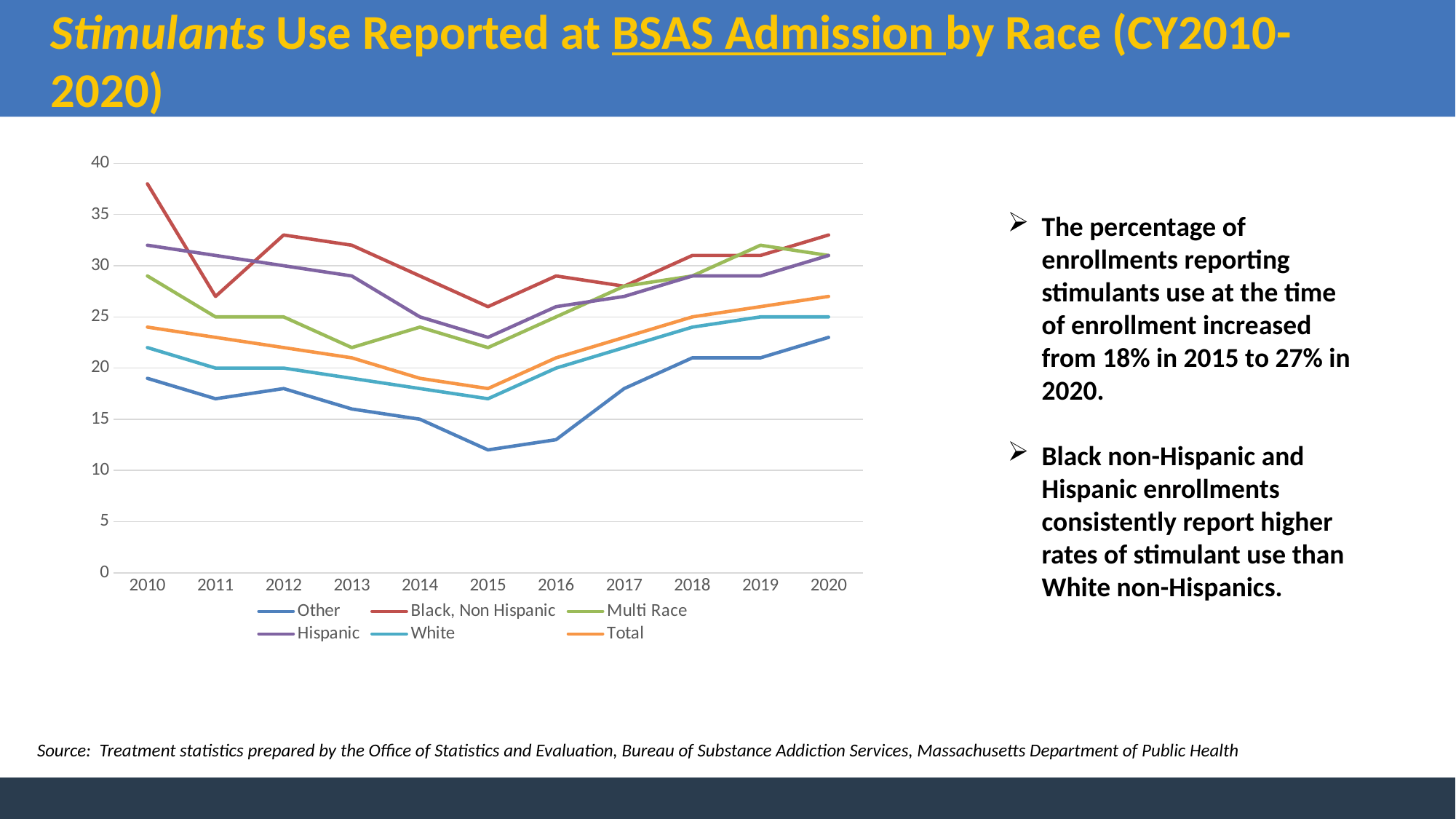
How many series does the legend list? 6 Is the value for Other in 2015 greater or less than 15? less In 2013, which is larger: the value for Hispanic or the value for White? Hispanic What kind of chart is shown on the slide? Line chart Is the value for Black, Non Hispanic in 2010 greater or less than 35? greater Which series has the lowest value in 2015? Other According to the slide, what percentage of enrollments reported stimulants use in 2020? 27% Which series has the highest value in 2010? Black, Non Hispanic Does the Other series rise or fall from 2015 to 2020? Rise How many years are shown along the x axis? 11 Is the value for White in 2015 greater or less than 20? less According to the slide, by how many percentage points did the percentage of enrollments reporting stimulants use increase from 2015 to 2020? 9